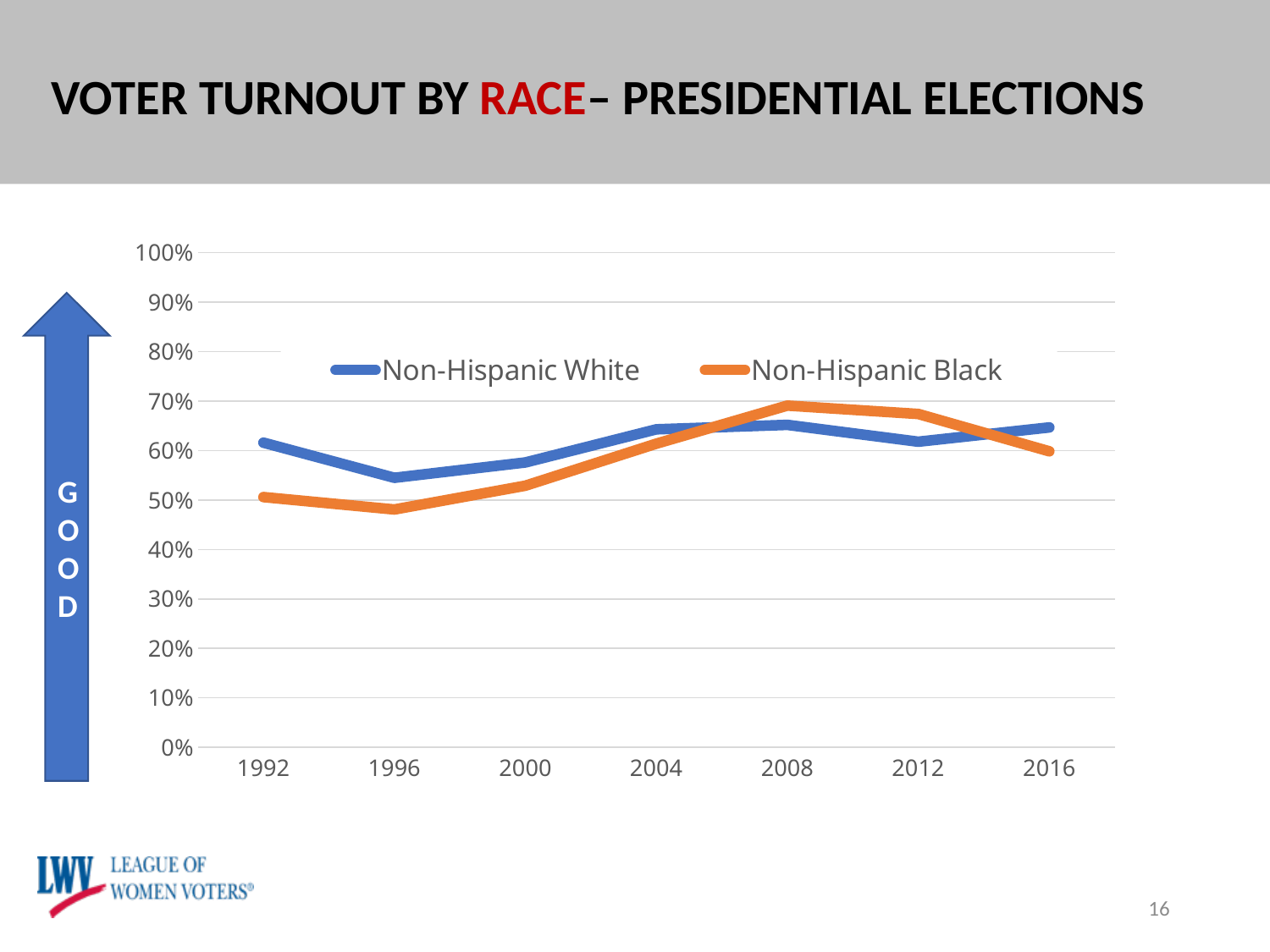
How many series does the chart legend list? 2 In 1992, which group had the higher turnout, Non-Hispanic White or Non-Hispanic Black? Non-Hispanic White Does the Non-Hispanic Black turnout rise or fall from 1996 to 2008? rise In which year is the Non-Hispanic White turnout lowest? 1996 In which year is the Non-Hispanic Black turnout highest? 2008 How many election years are plotted along the x axis? 7 Is the Non-Hispanic Black turnout in 1996 greater or less than 50%? less Is the Non-Hispanic Black turnout in 2008 greater or less than 60%? greater In 2008, which group had the higher turnout, Non-Hispanic White or Non-Hispanic Black? Non-Hispanic Black What kind of chart is shown on the slide? Line chart Is the Non-Hispanic White turnout in 1996 greater or less than 50%? greater In which year is the Non-Hispanic Black turnout lowest? 1996